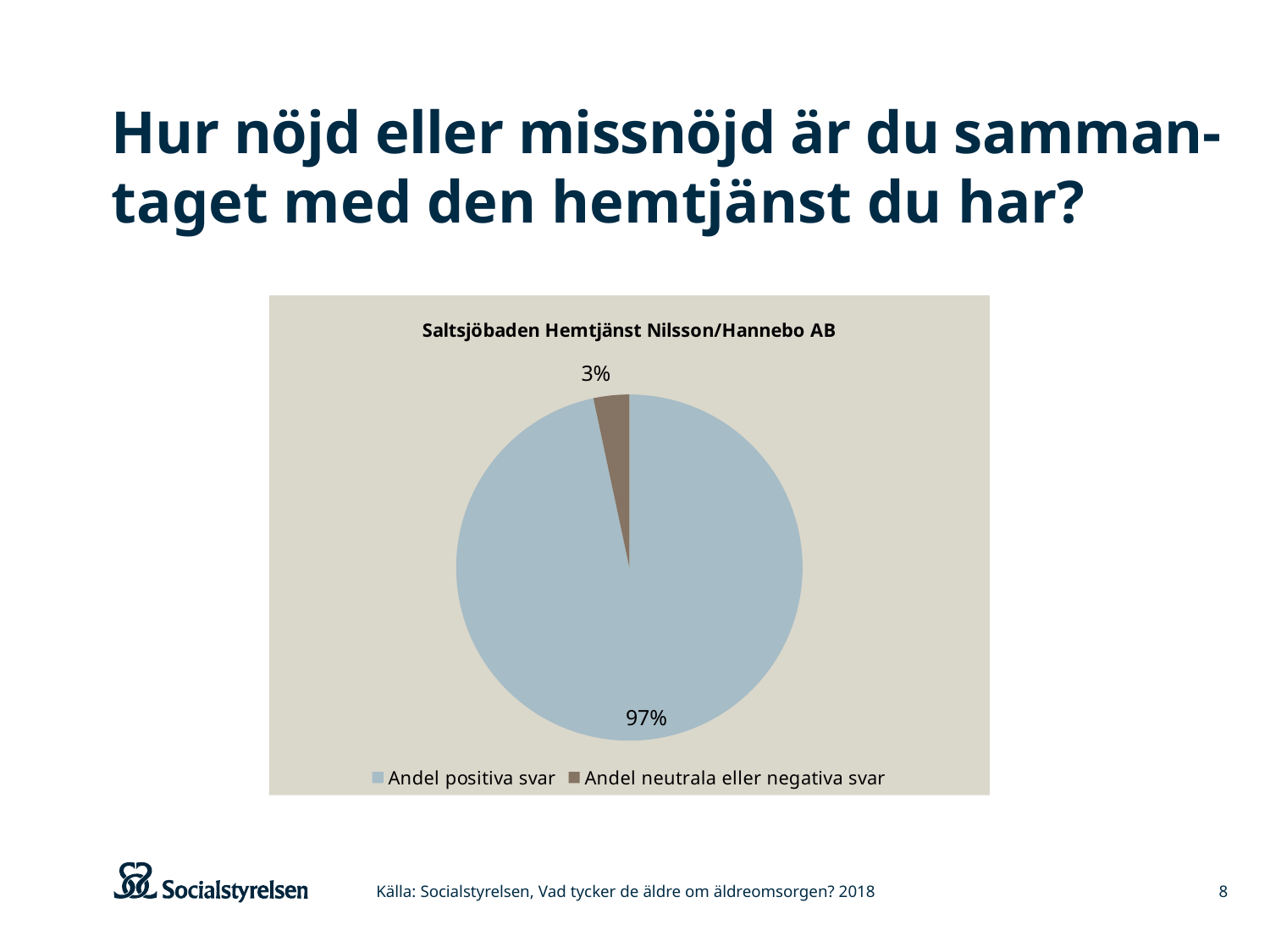
What colour is the 'Andel neutrala eller negativa svar' slice? brown How many slices does the pie chart have? 2 What share of the pie is 'Andel neutrala eller negativa svar'? 3% Which is larger, 'Andel positiva svar' or 'Andel neutrala eller negativa svar'? Andel positiva svar What is the difference between the 'Andel positiva svar' share and the 'Andel neutrala eller negativa svar' share? 94% What share of the pie is 'Andel positiva svar'? 97% What kind of chart is shown on the slide? pie chart What is the chart's title? Saltsjöbaden Hemtjänst Nilsson/Hannebo AB Which slice is the largest? Andel positiva svar Which slice is the smallest? Andel neutrala eller negativa svar How many entries does the legend list? 2